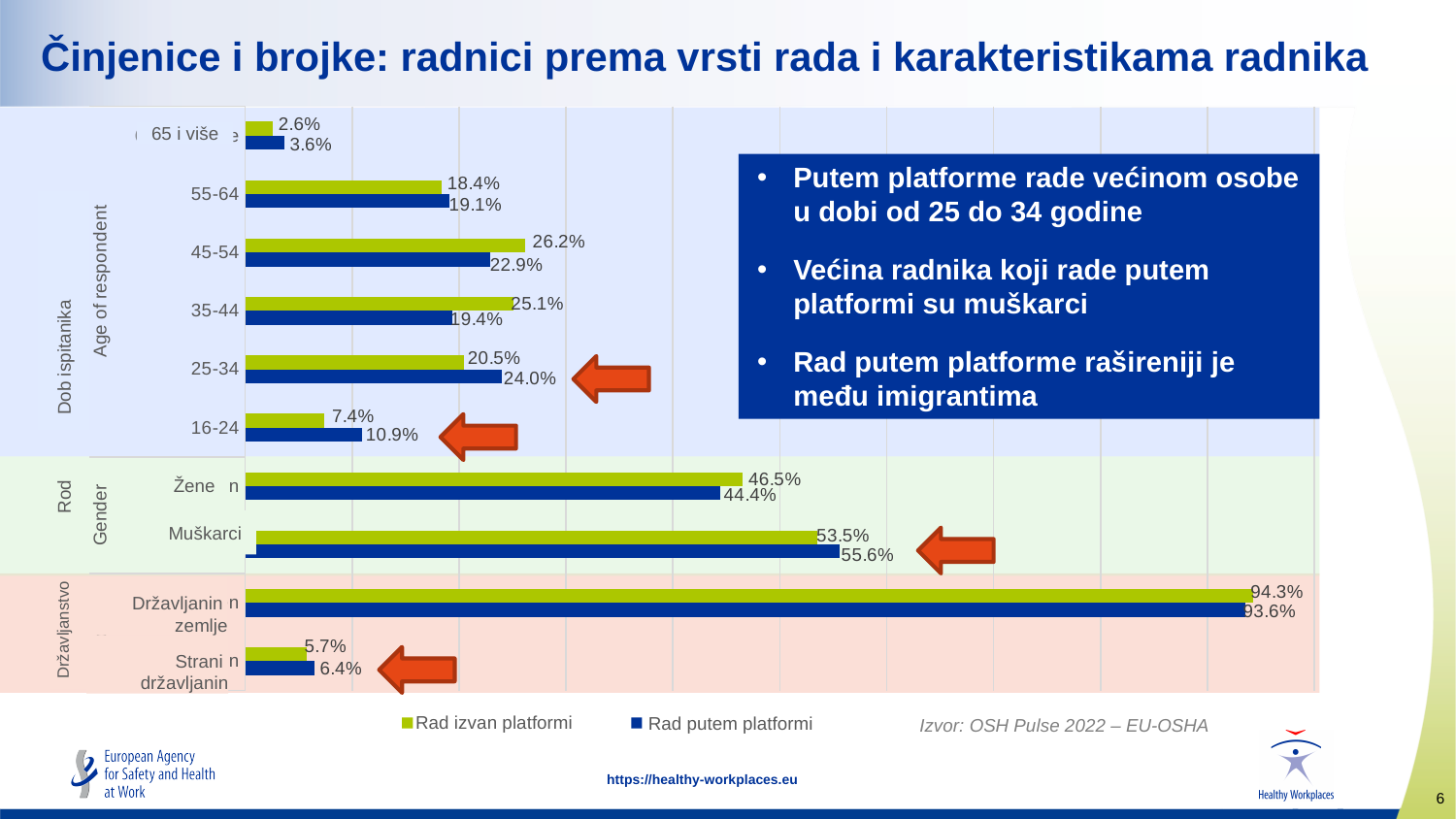
What is the difference between "Rad putem platformi" and "Rad izvan platformi" for the 16-24 age group? 3.5% What is the value of "Rad putem platformi" for Državljanin zemlje? 93.6% How many categories are plotted on the chart? 10 What is the value of "Rad putem platformi" for Muškarci? 55.6% What is the value of "Rad izvan platformi" for Strani državljanin? 5.7% What kind of chart is shown on the slide? bar chart What is the value of "Rad izvan platformi" for the 45-54 age group? 26.2% Among the age groups, which has the highest value for "Rad putem platformi"? 25-34 For Žene, which series has the larger value, "Rad izvan platformi" or "Rad putem platformi"? Rad izvan platformi How many series does the legend list? 2 Among the age groups, which has the lowest value for "Rad izvan platformi"? 65 i više What is the value of "Rad putem platformi" for the 25-34 age group? 24.0%